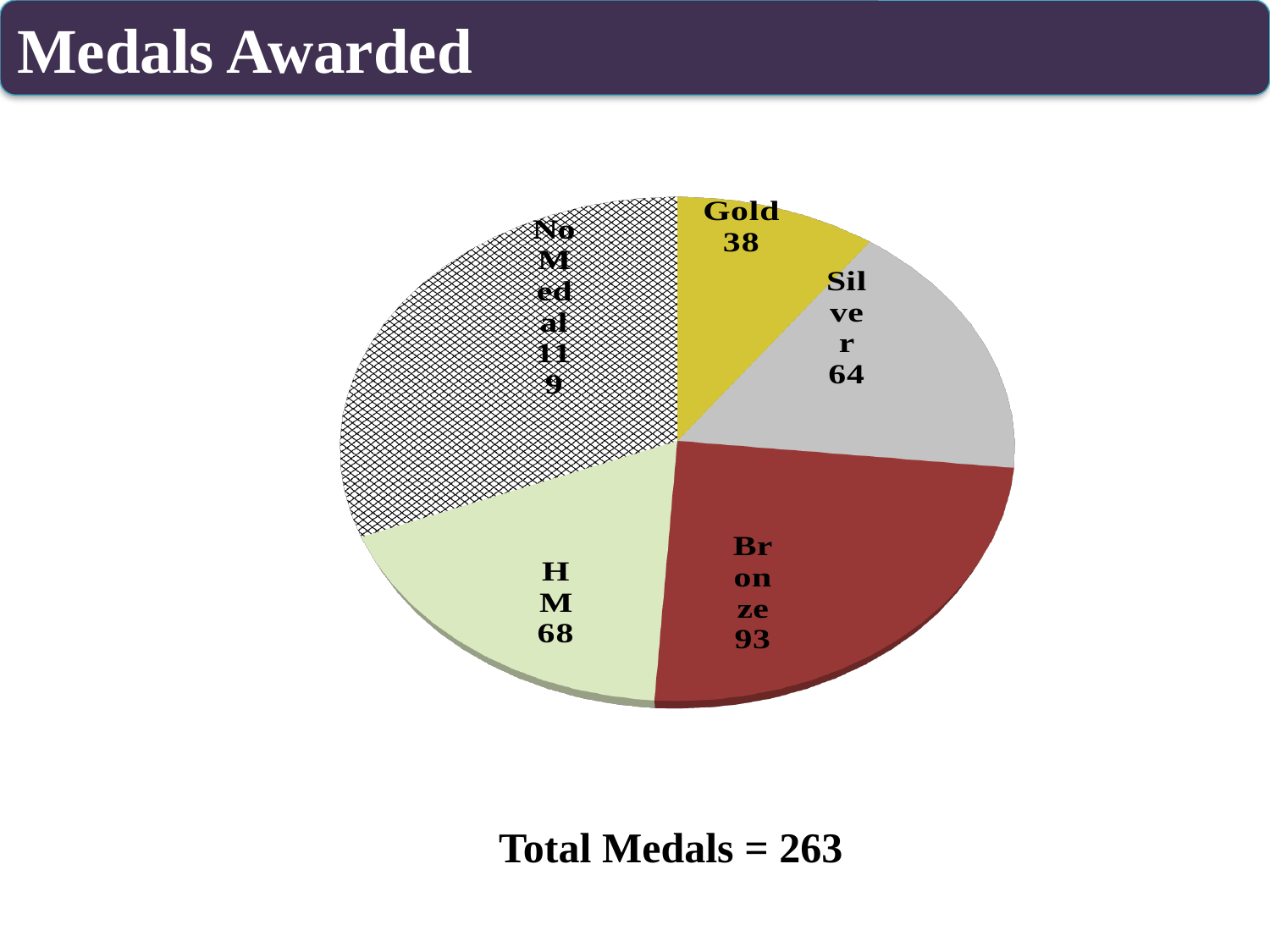
What type of chart is shown on the slide? pie chart What is the value for HM? 68 What is the value for Silver? 64 Which slice has the largest value? No Medal What is the title of the slide containing the chart? Medals Awarded What is the value for Bronze? 93 What is the value for No Medal? 119 Which is larger, the value for HM or the value for Silver? HM Which slice has the smallest value? Gold How many slices does the pie chart have? 5 What is the difference between the Bronze and Silver values? 29 What is the value for Gold? 38